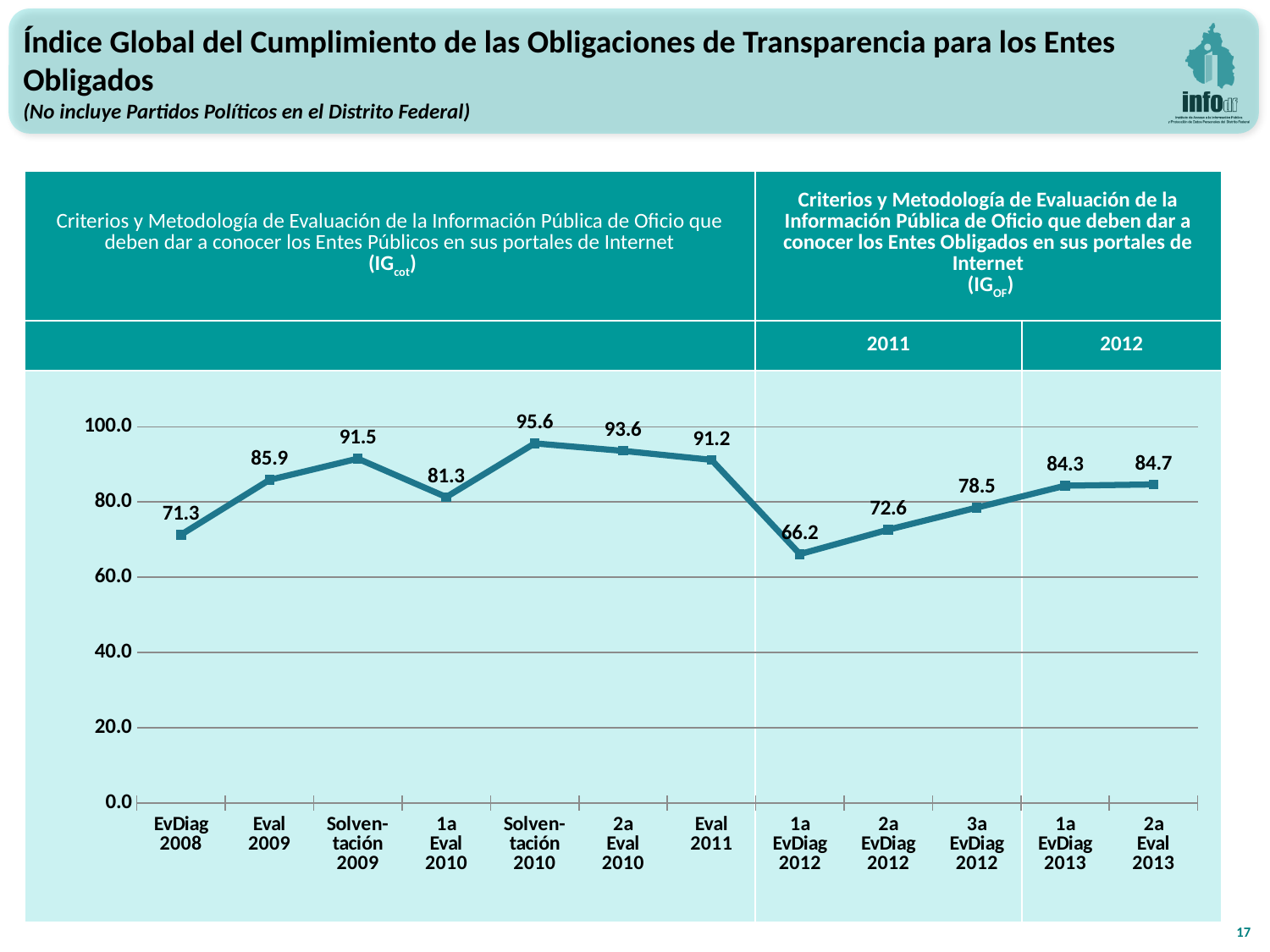
What is the value for EvDiag 2008? 71.3 Which category has the highest value? Solventación 2010 What kind of chart is shown on the slide? line chart Which is larger, the value for Solventación 2009 or the value for Eval 2011? Solventación 2009 How many data points are plotted on the chart? 12 What is the value for 1a EvDiag 2012? 66.2 Do the values rise or fall from 1a EvDiag 2012 to 2a Eval 2013? rise Is the value for 3a EvDiag 2012 greater or less than 80.0? less What is the value for 2a Eval 2013? 84.7 Which category has the lowest value? 1a EvDiag 2012 What is the difference between the values for Solventación 2010 and 1a EvDiag 2012? 29.4 What is the difference between the values for Eval 2009 and EvDiag 2008? 14.6